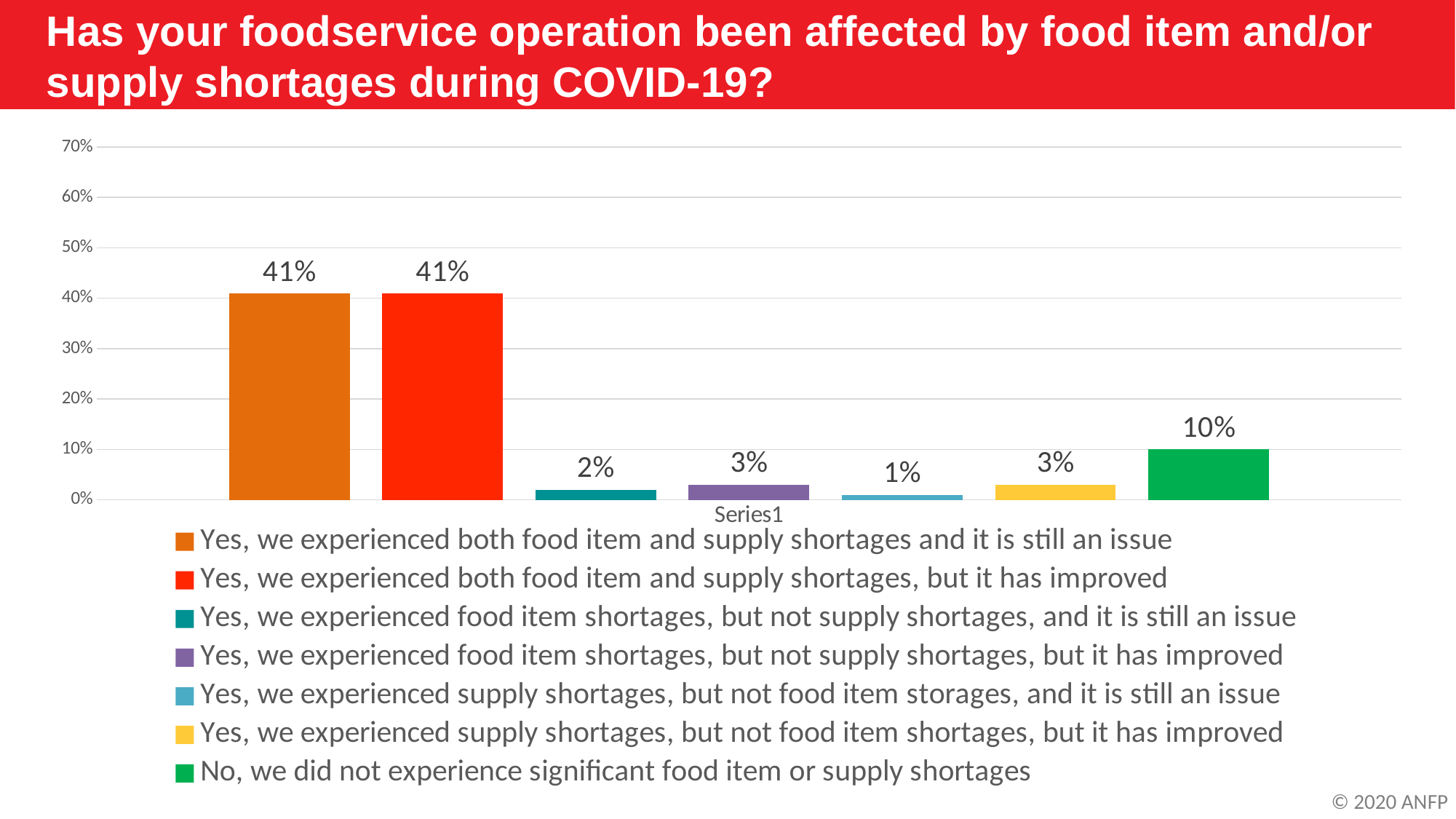
Which is larger: the percentage for 'No, we did not experience significant food item or supply shortages' or the percentage for 'Yes, we experienced food item shortages, but not supply shortages, and it is still an issue'? No, we did not experience significant food item or supply shortages What percentage of respondents said they did not experience significant food item or supply shortages? 10% What percentage of respondents said they experienced food item shortages, but not supply shortages, and it is still an issue? 2% How many response categories (bars) are shown in the chart? 7 Which response category has the lowest percentage? Yes, we experienced supply shortages, but not food item storages, and it is still an issue What percentage of respondents said they experienced both food item and supply shortages and it is still an issue? 41% What colour is the bar for 'No, we did not experience significant food item or supply shortages'? Green How many entries does the legend list? 7 What type of chart is shown on the slide? Bar chart What is the difference in percentage points between 'No, we did not experience significant food item or supply shortages' and 'Yes, we experienced food item shortages, but not supply shortages, but it has improved'? 7% What percentage of respondents said they experienced supply shortages, but not food item shortages, but it has improved? 3% What percentage of respondents said they experienced both food item and supply shortages, but it has improved? 41%